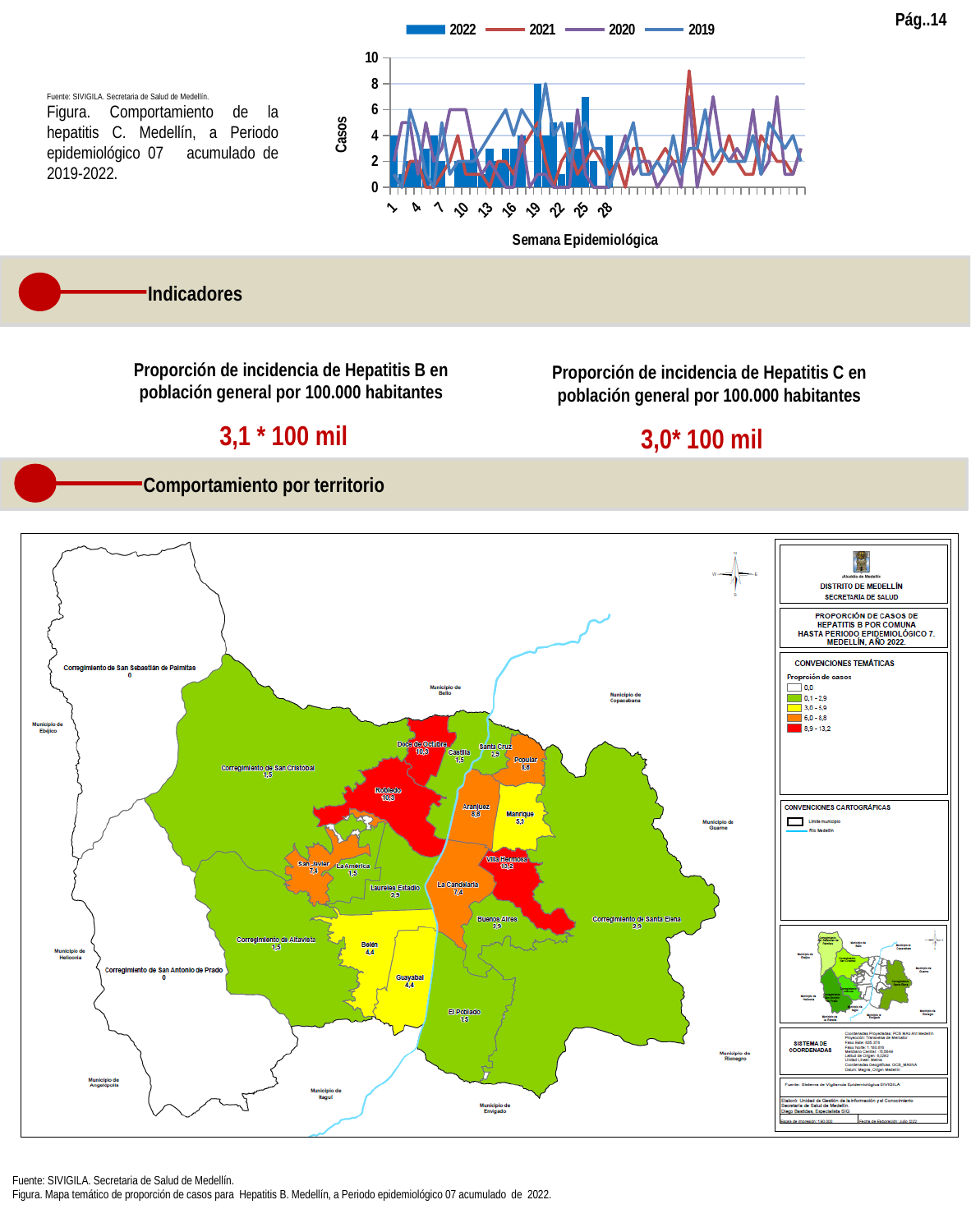
On the map of Hepatitis B proportion by comuna, which comuna has the highest printed value? Villa Hermosa On the map of Hepatitis B proportion by comuna, which is larger, the value for Popular or the value for Belén? Popular In the chart at the top of the slide, which year's series is drawn as bars rather than a line? 2022 In the chart at the top of the slide, is the 2022 bar at week 19 greater or less than 6? greater In the chart at the top of the slide, is the peak value of the 2021 series greater or less than 8? greater Which years are listed in the legend of the chart at the top of the slide? 2022, 2021, 2020, 2019 On the map of Hepatitis B proportion by comuna, what value is printed for Villa Hermosa? 13,2 On the map of Hepatitis B proportion by comuna, what value is printed for Manrique? 5,3 How many series does the legend of the line chart at the top of the slide list? 4 What is the title of the vertical axis of the chart at the top of the slide? Casos What is the highest tick value shown on the vertical axis of the chart at the top of the slide? 10